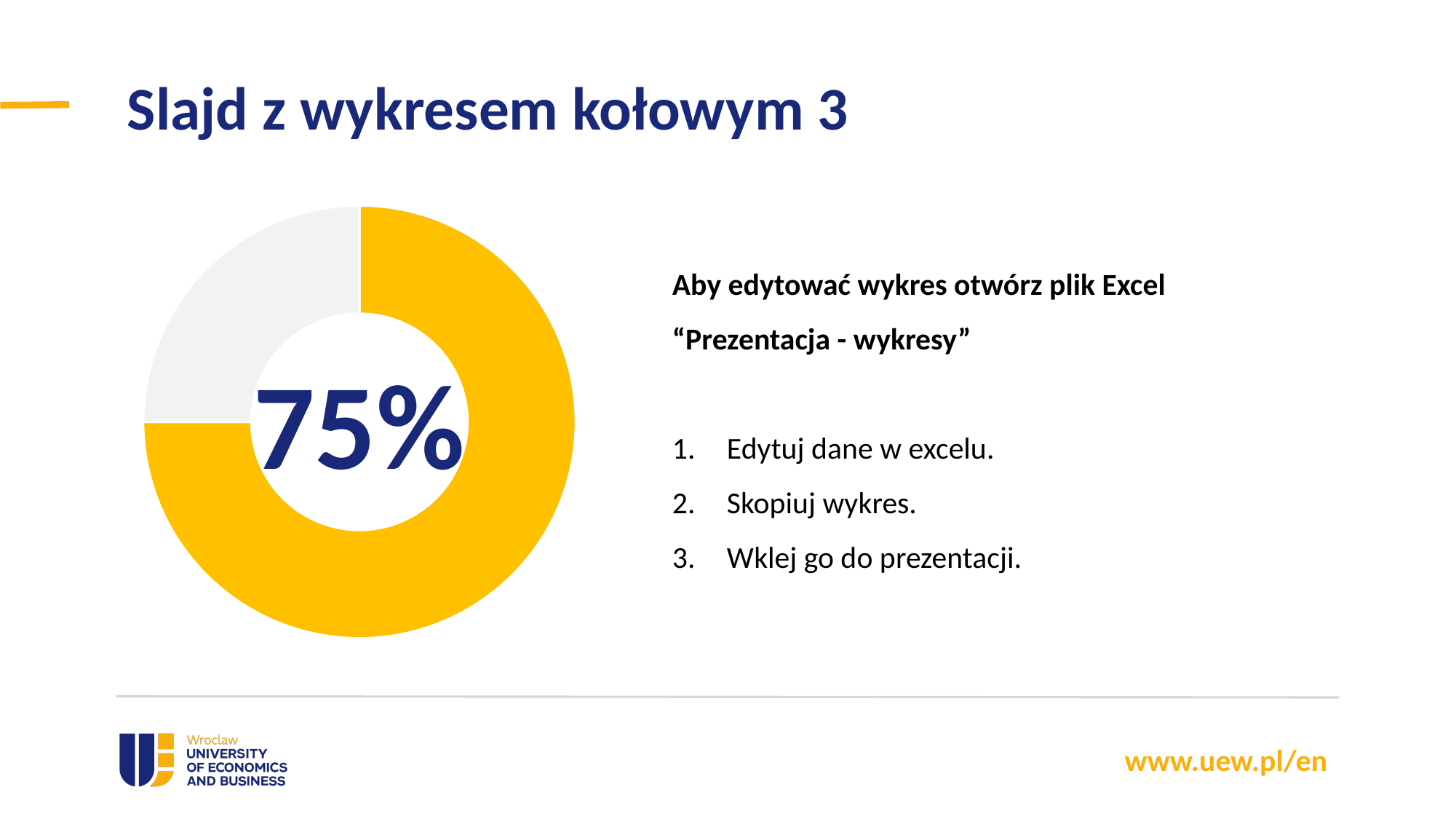
How many slices does the donut chart have? 2 What percentage is printed in the centre of the donut chart? 75% What share of the donut chart does the yellow slice represent? 75% What kind of chart is shown on the slide? Pie chart (donut) What is the title of the slide containing the donut chart? Slajd z wykresem kołowym 3 Which slice of the donut chart is larger, the yellow one or the grey one? The yellow one What colour is the larger slice of the donut chart? Yellow